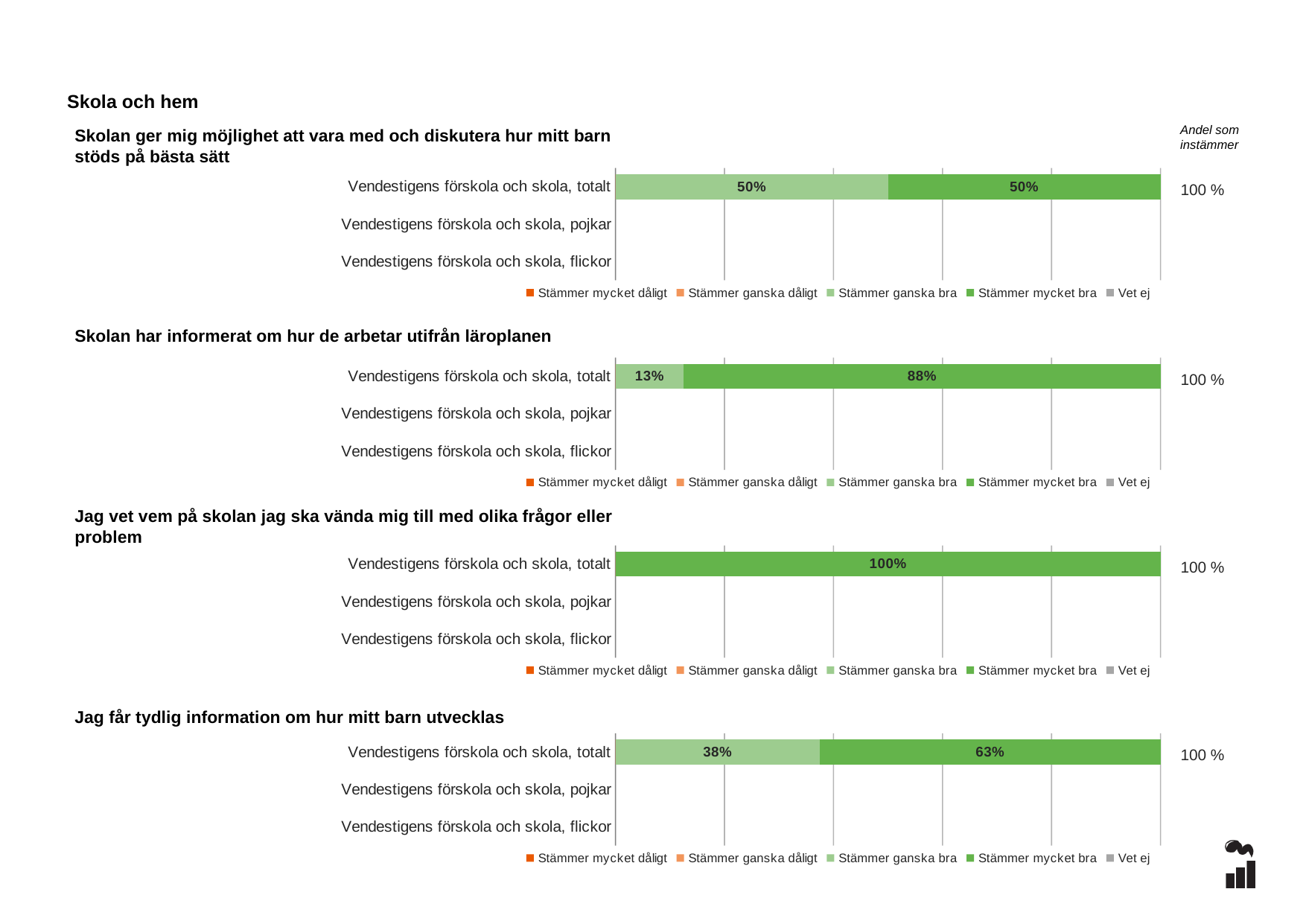
In the chart 'Jag får tydlig information om hur mitt barn utvecklas', what is the value for 'Stämmer ganska bra' for Vendestigens förskola och skola, totalt? 38% How many series does the legend of the chart 'Skolan ger mig möjlighet att vara med och diskutera hur mitt barn stöds på bästa sätt' list? 5 In the chart 'Skolan ger mig möjlighet att vara med och diskutera hur mitt barn stöds på bästa sätt', what is the value for 'Stämmer ganska bra' for Vendestigens förskola och skola, totalt? 50% In the chart 'Skolan har informerat om hur de arbetar utifrån läroplanen', what is the value for 'Stämmer mycket bra' for Vendestigens förskola och skola, totalt? 88% In the chart 'Skolan har informerat om hur de arbetar utifrån läroplanen', what is the value for 'Stämmer ganska bra' for Vendestigens förskola och skola, totalt? 13% In the chart 'Jag vet vem på skolan jag ska vända mig till med olika frågor eller problem', what is the value for 'Stämmer mycket bra' for Vendestigens förskola och skola, totalt? 100% How many categories are shown on the y axis of the chart 'Jag får tydlig information om hur mitt barn utvecklas'? 3 What kind of chart is 'Skolan har informerat om hur de arbetar utifrån läroplanen'? Stacked bar chart In the chart 'Jag får tydlig information om hur mitt barn utvecklas', what is the difference between the 'Stämmer mycket bra' and 'Stämmer ganska bra' values for Vendestigens förskola och skola, totalt? 25% What is the 'Andel som instämmer' value shown to the right of the chart 'Jag får tydlig information om hur mitt barn utvecklas'? 100 % In the chart 'Skolan har informerat om hur de arbetar utifrån läroplanen', which is larger for Vendestigens förskola och skola, totalt: 'Stämmer ganska bra' or 'Stämmer mycket bra'? Stämmer mycket bra In the chart 'Jag får tydlig information om hur mitt barn utvecklas', what is the value for 'Stämmer mycket bra' for Vendestigens förskola och skola, totalt? 63%